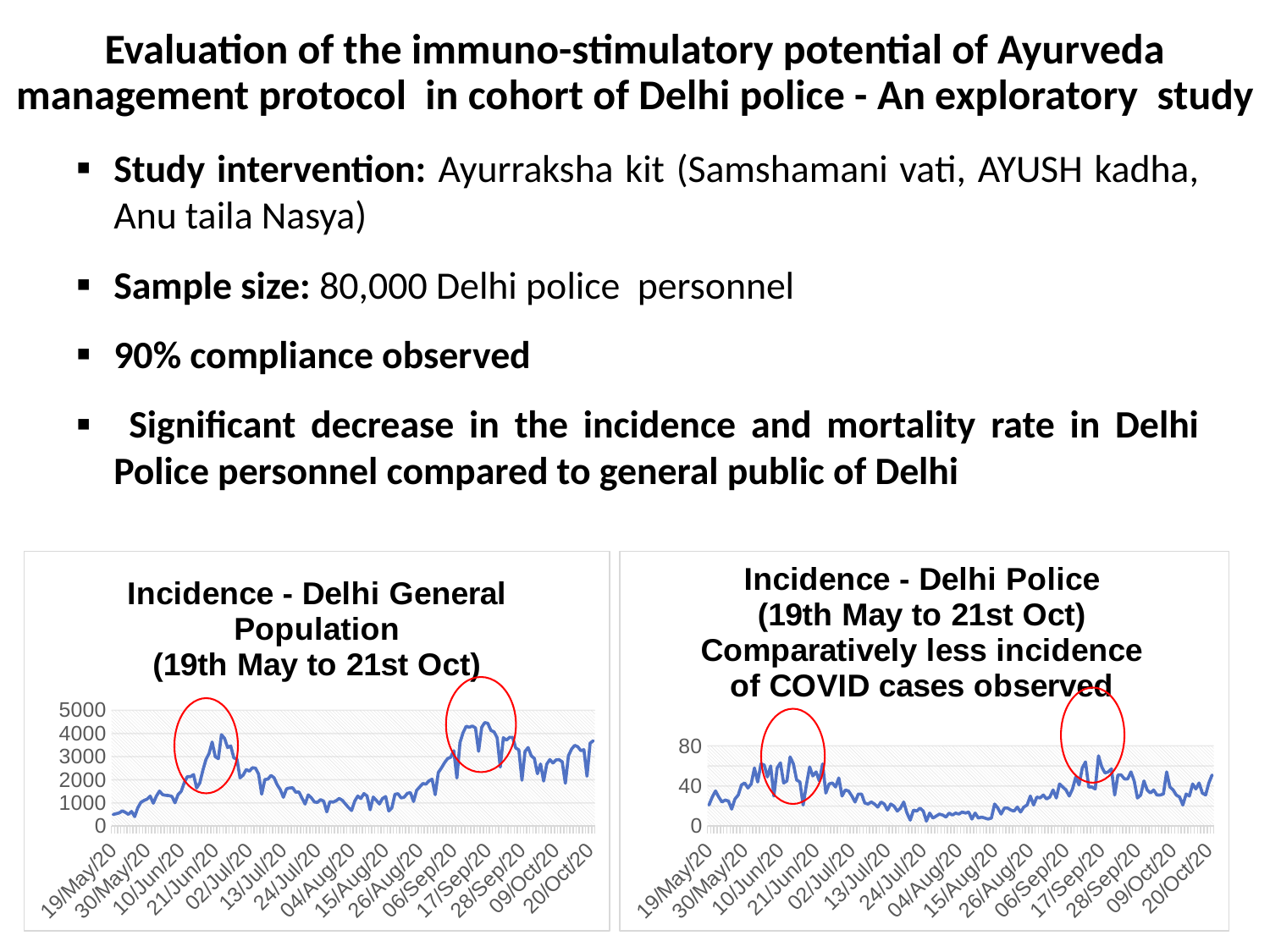
In the 'Incidence - Delhi General Population' chart, is the value on 19/May/20 greater or less than 1000? less In the 'Incidence - Delhi General Population' chart, is the value around 04/Aug/20 greater or less than 2000? less In the 'Incidence - Delhi General Population' chart, do the values rise or fall between 21/Jun/20 and 04/Aug/20? fall What kind of chart is the 'Incidence - Delhi General Population' chart on the left? line chart What date range is given in the title of the 'Incidence - Delhi Police' chart? 19th May to 21st Oct What is the highest value shown on the y axis of the 'Incidence - Delhi General Population' chart? 5000 In the 'Incidence - Delhi General Population' chart, is the peak value in mid-September greater or less than 4000? greater How many lines are plotted in the 'Incidence - Delhi Police' chart? 1 In the 'Incidence - Delhi Police' chart, do the values rise or fall between 15/Aug/20 and 17/Sep/20? rise What kind of chart is the 'Incidence - Delhi Police' chart on the right? line chart